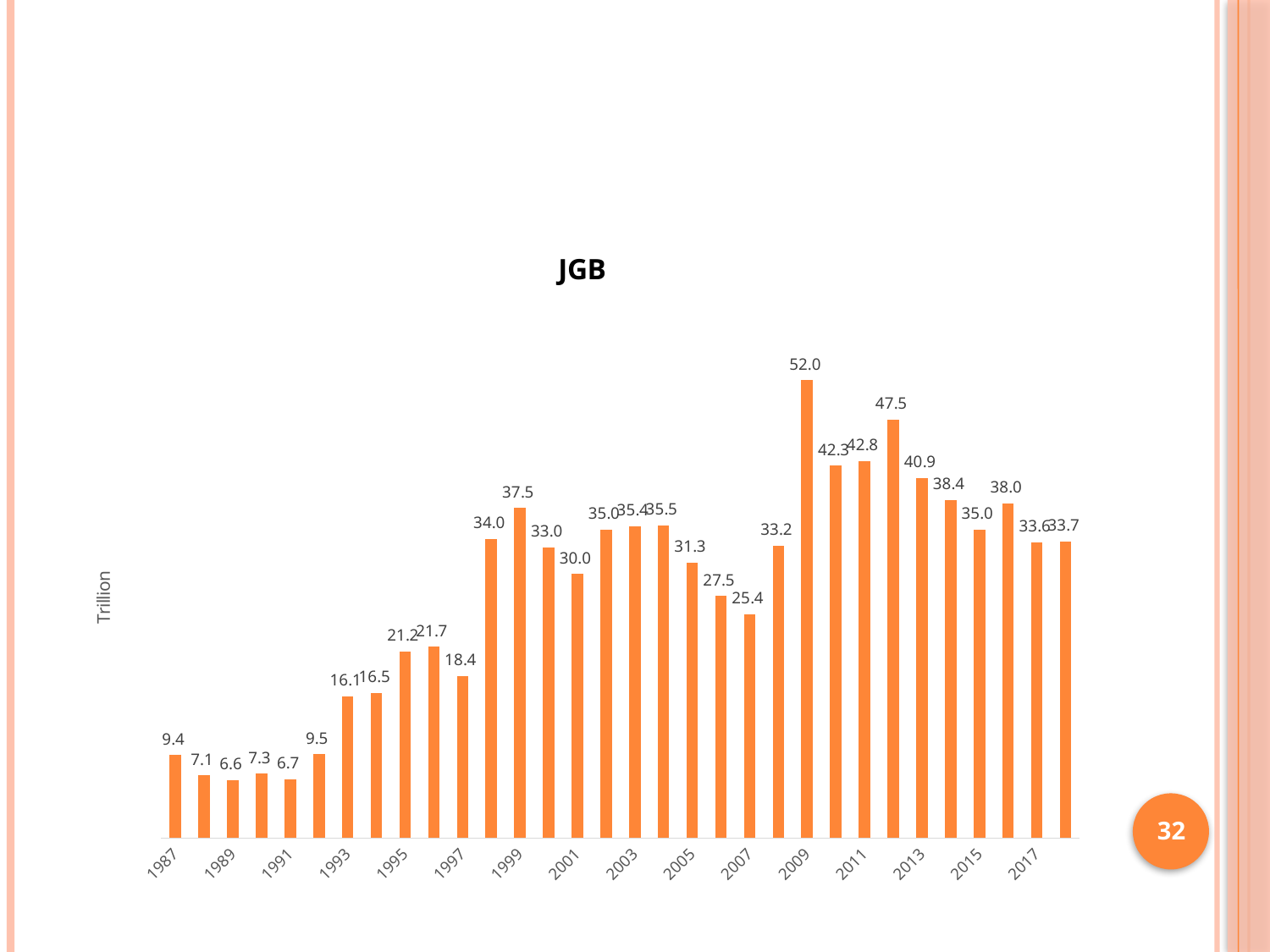
What kind of chart is shown on the slide? Bar chart Which year has the lowest value in the JGB chart? 1989 Do the values in the JGB chart rise or fall from 1987 to 1999? Rise What is the value for 1999 in the JGB chart? 37.5 What is the value for 1987 in the JGB chart? 9.4 What is the value for 2013 in the JGB chart? 40.9 Which year has the larger value in the JGB chart, 1999 or 2013? 2013 What is the difference between the values for 2009 and 1987 in the JGB chart? 42.6 How many bars are plotted in the JGB chart? 32 What is the label on the vertical axis of the JGB chart? Trillion What is the value for 2009 in the JGB chart? 52.0 Which year has the highest value in the JGB chart? 2009